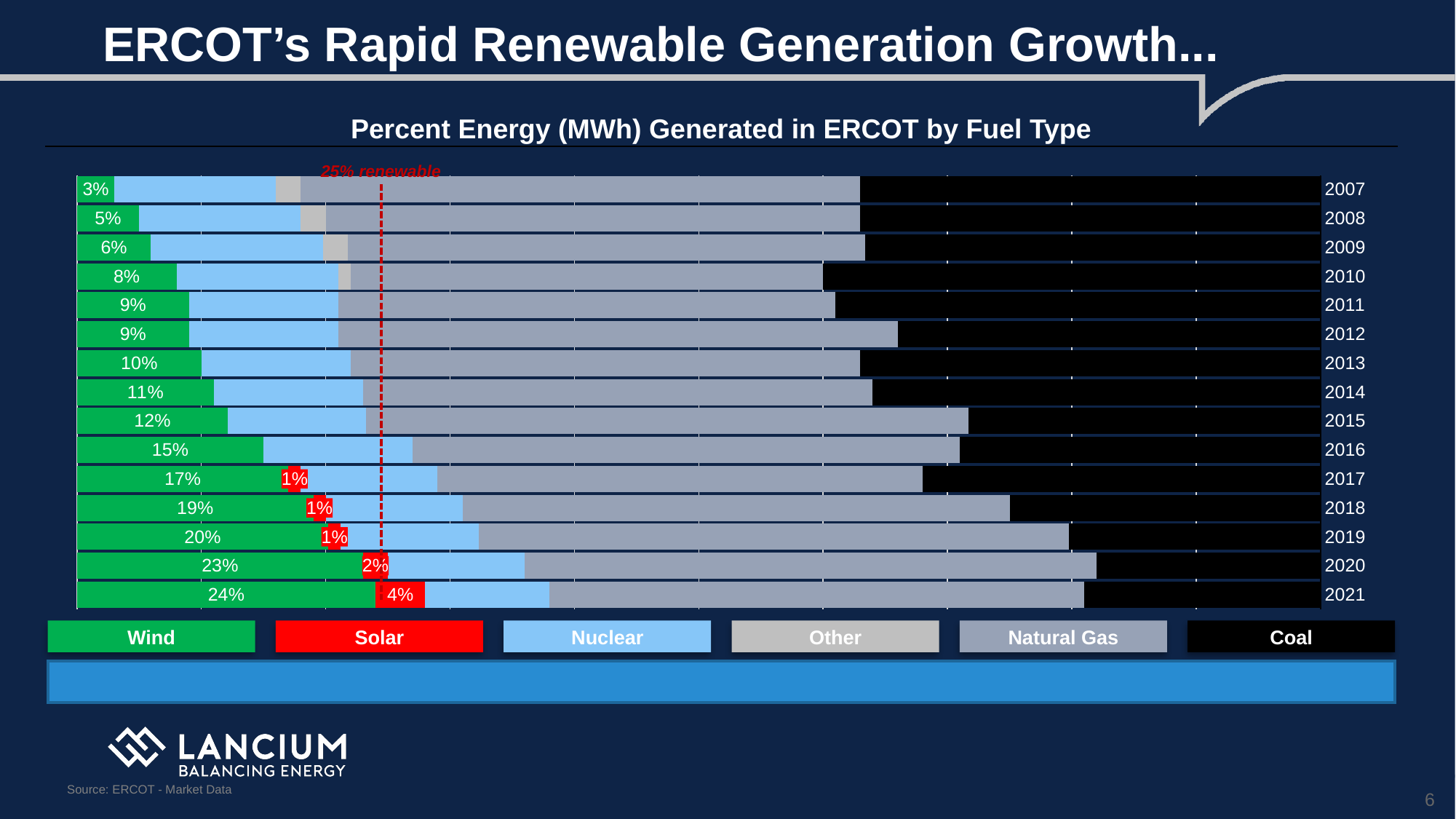
What is the Wind share of energy generated in ERCOT in 2007? 3% Which year has the highest Wind share? 2021 Does the Wind share rise or fall from 2007 to 2021? Rise What is the Solar share of energy generated in ERCOT in 2020? 2% How many years are shown in the chart? 15 What is the Solar share of energy generated in ERCOT in 2021? 4% How many fuel types does the legend list? 6 What is the Wind share of energy generated in ERCOT in 2021? 24% Which year has a larger Wind share, 2015 or 2016? 2016 Which year has the lowest Wind share? 2007 By how many percentage points did the Wind share grow from 2007 to 2021? 21% What kind of chart is shown on the slide? Stacked bar chart